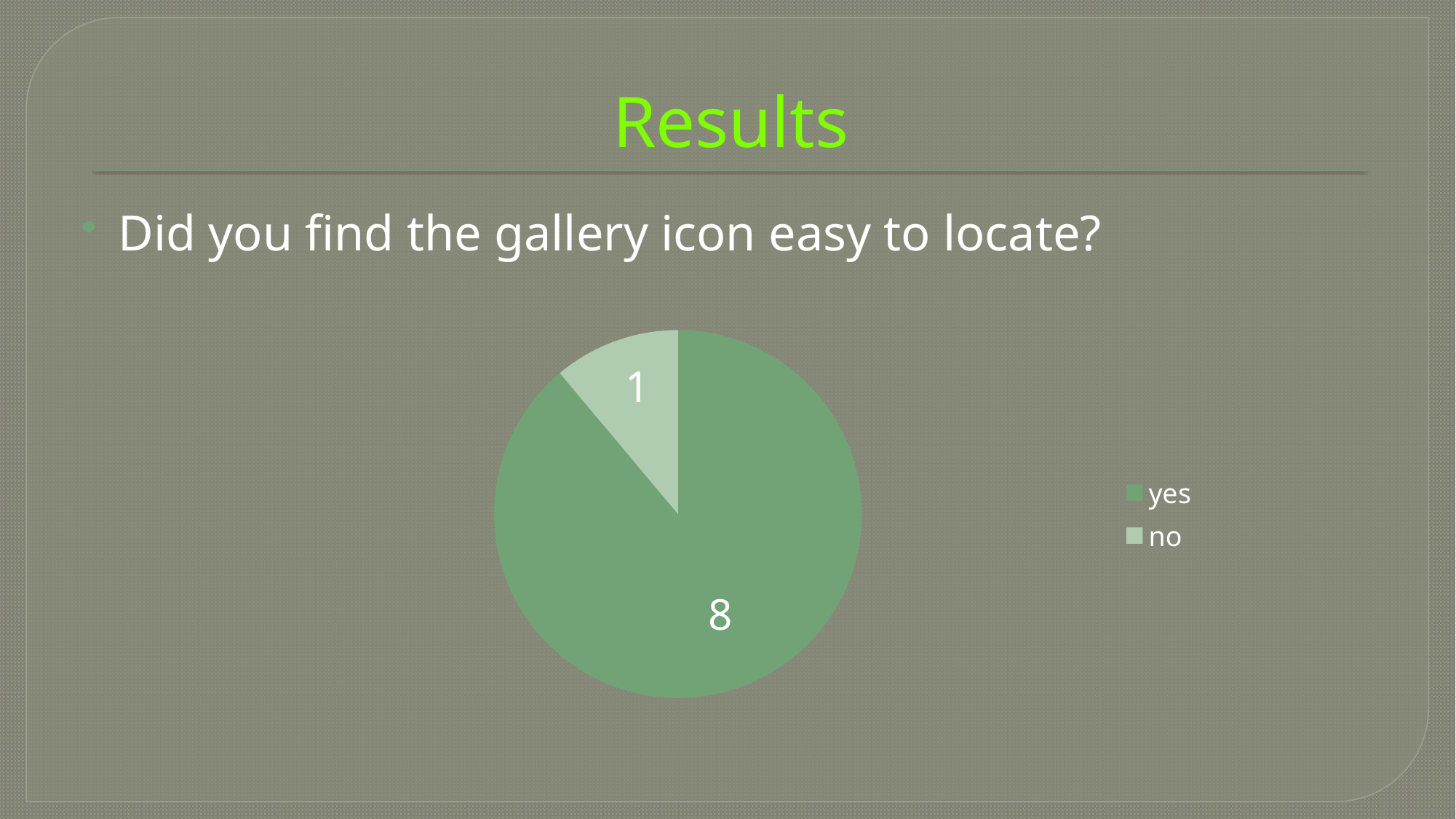
How many respondents answered "yes"? 8 Which legend entry is shown in the lighter green colour? no What kind of chart is shown on the slide? pie chart How many entries does the legend list? 2 Which is larger, the "yes" slice or the "no" slice? yes What question do the pie chart results answer? Did you find the gallery icon easy to locate? Which category has the smallest slice of the pie? no What is the difference between the "yes" and "no" counts? 7 How many categories does the pie chart have? 2 How many respondents answered "no"? 1 Which category has the largest slice of the pie? yes What is the total of all slices in the pie chart? 9